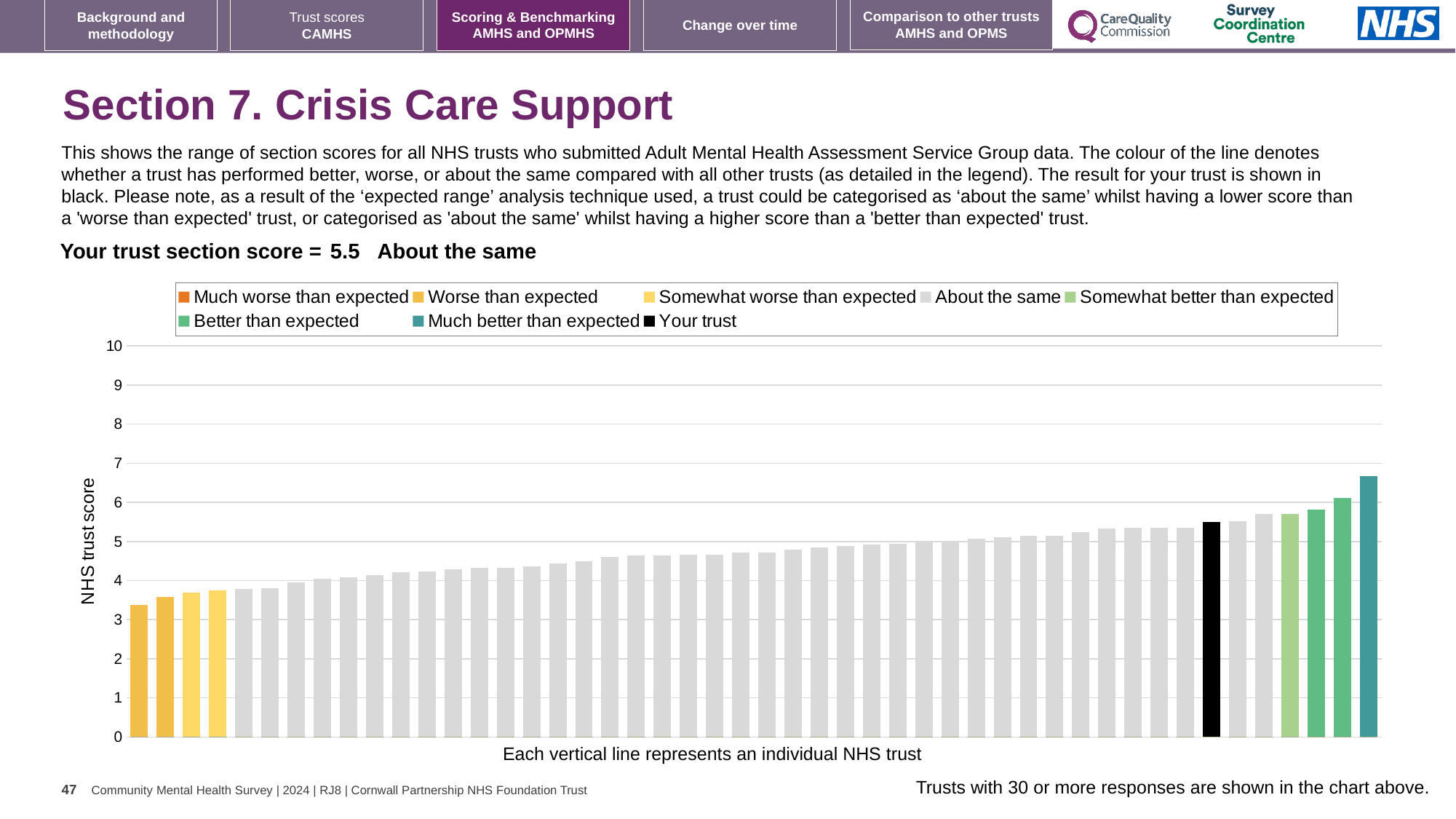
How many entries does the chart legend list? 8 What is the label on the vertical axis of the chart? NHS trust score What is the section score for your trust shown on the slide? 5.5 Is the value of the highest bar in the chart greater or less than 6? greater Do the bar values rise or fall from left to right across the chart? rise Which is higher: the rightmost bar or the black 'Your trust' bar? the rightmost bar Is the value of the lowest bar in the chart greater or less than 4? less Which legend category does the lowest bar in the chart belong to? Worse than expected Is the value for your trust (the black bar) greater or less than 5? greater What type of chart is shown on the slide? bar chart Which legend category does the highest bar in the chart belong to? Much better than expected Which category is your trust's section score placed in? About the same